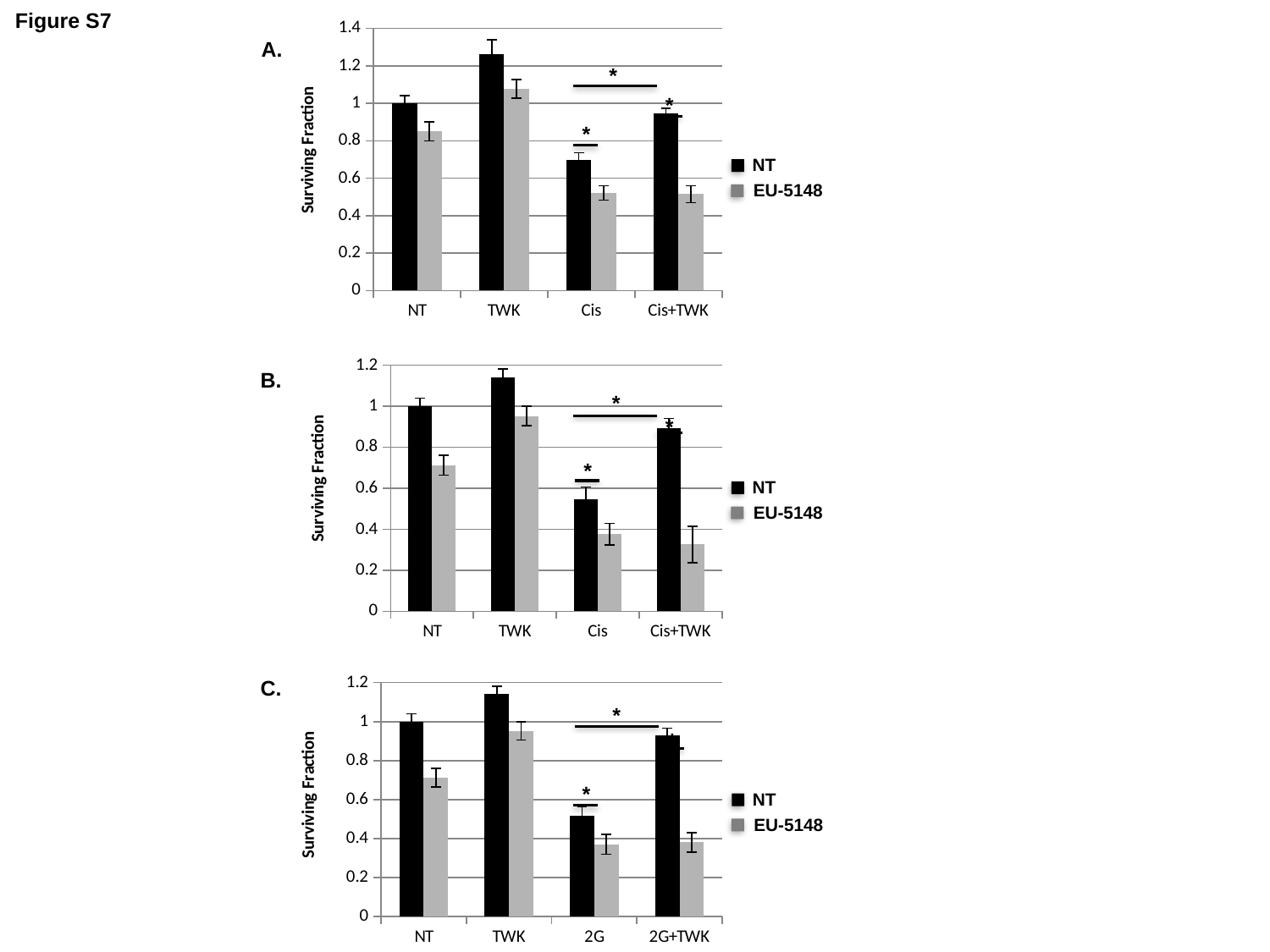
In chart A (top), for the TWK category, which series has the larger value, NT or EU-5148? NT In chart C (bottom), is the NT value for 2G greater or less than 0.6? less In chart C (bottom), which category has the highest EU-5148 value? TWK In chart A (top), is the NT value for Cis greater or less than 0.8? less In chart B (middle), which category has the lowest NT value? Cis In chart C (bottom), what are the category labels on the x axis? NT, TWK, 2G, 2G+TWK In chart A (top), how many series does the legend list? 2 In chart B (middle), is the EU-5148 value for NT greater or less than 0.6? greater In chart A (top), how many categories are shown on the x axis? 4 In chart A (top), which category has the highest NT value? TWK In chart A (top), what kind of chart is shown? bar chart In chart B (middle), what is the y-axis title? Surviving Fraction